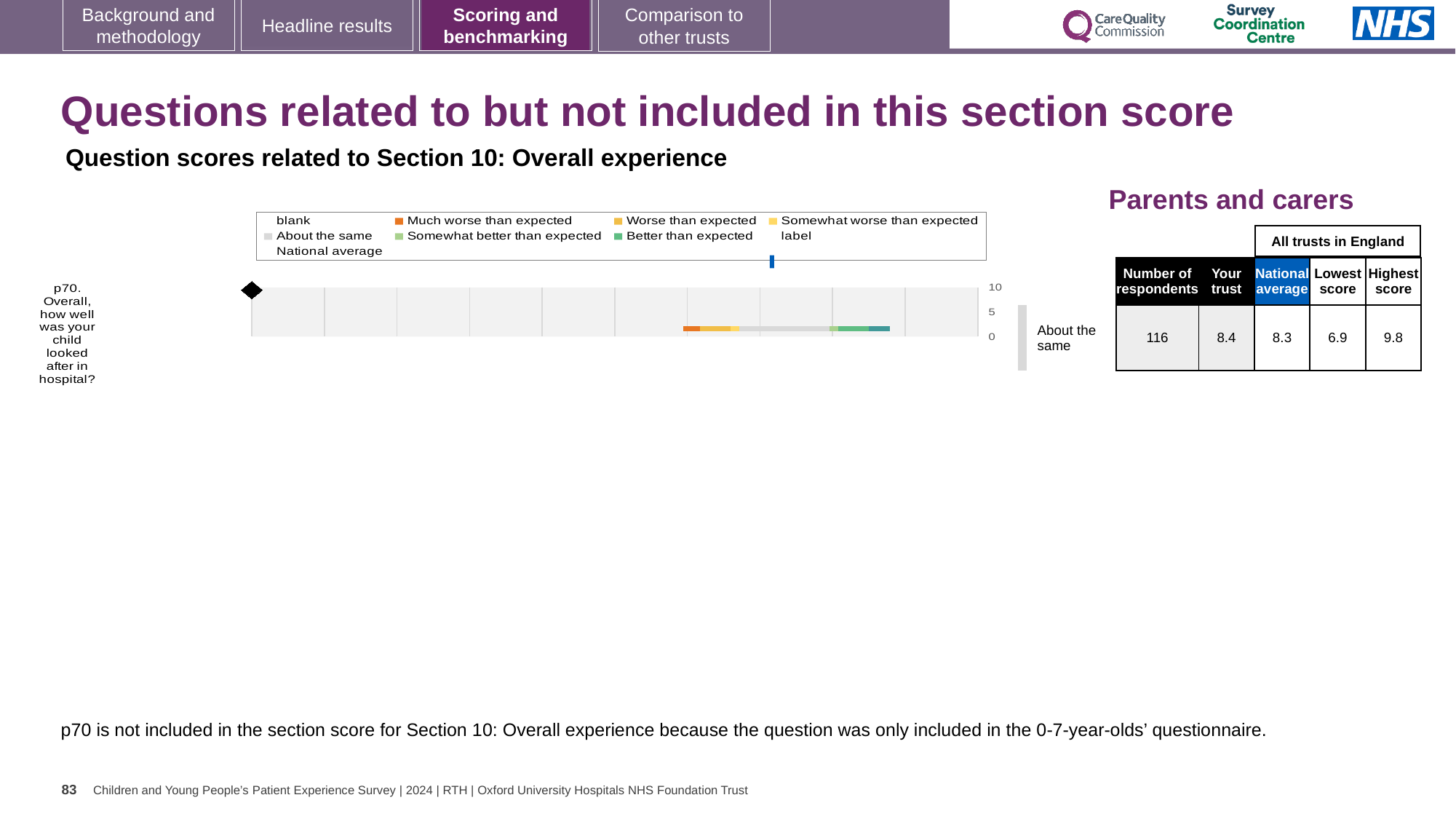
What is the difference between the 'Your trust' score and the national average for p70? 0.1 What is the difference between the highest and lowest scores for p70? 2.9 How many respondents answered p70? 116 Which is larger for p70, the 'Your trust' score or the national average? Your trust What benchmark category is shown next to the chart for p70? About the same What is the lowest score among all trusts in England for p70? 6.9 What is the national average score for p70? 8.3 What kind of chart is shown for question p70? bar chart Which question is plotted in the chart? p70. Overall, how well was your child looked after in hospital? What is the highest score among all trusts in England for p70? 9.8 How many questions are plotted in the chart? 1 What is the 'Your trust' score for p70 in the table? 8.4